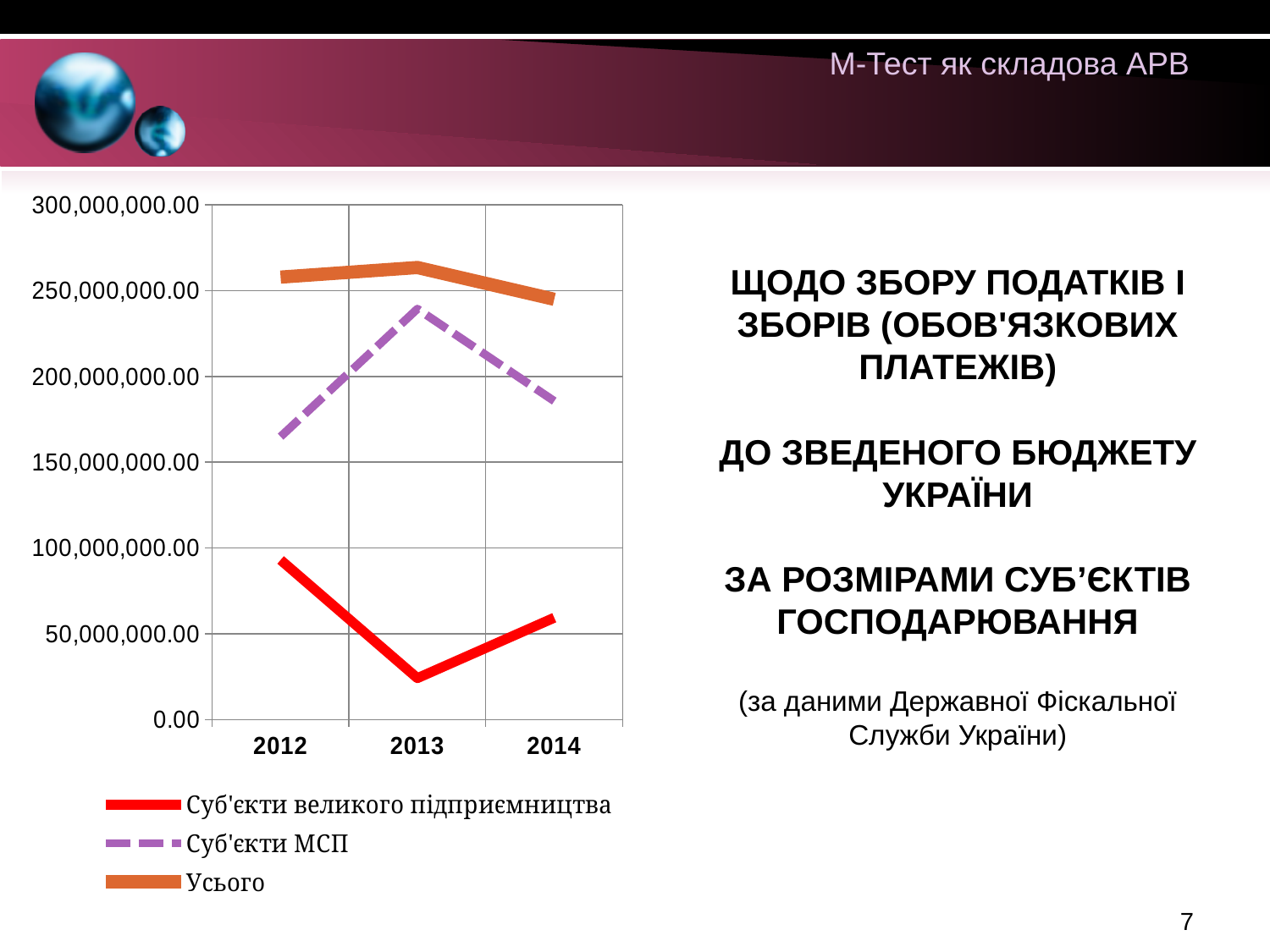
What kind of chart is shown on the slide? line chart Is the value for Суб'єкти великого підприємництва in 2013 greater or less than 50,000,000.00? less In which year is the value for Суб'єкти МСП the lowest? 2012 Does the value for Суб'єкти великого підприємництва rise or fall from 2012 to 2013? fall In which year is the value for Суб'єкти МСП the highest? 2013 How many series does the chart legend list? 3 Which series is drawn with a dashed purple line? Суб'єкти МСП Is the value for Суб'єкти МСП in 2013 greater or less than 200,000,000.00? greater In which year is the value for Суб'єкти великого підприємництва the highest? 2012 Which series has the larger value in 2012: Суб'єкти МСП or Суб'єкти великого підприємництва? Суб'єкти МСП How many years are shown on the x axis of the chart? 3 In which year is the value for Суб'єкти великого підприємництва the lowest? 2013